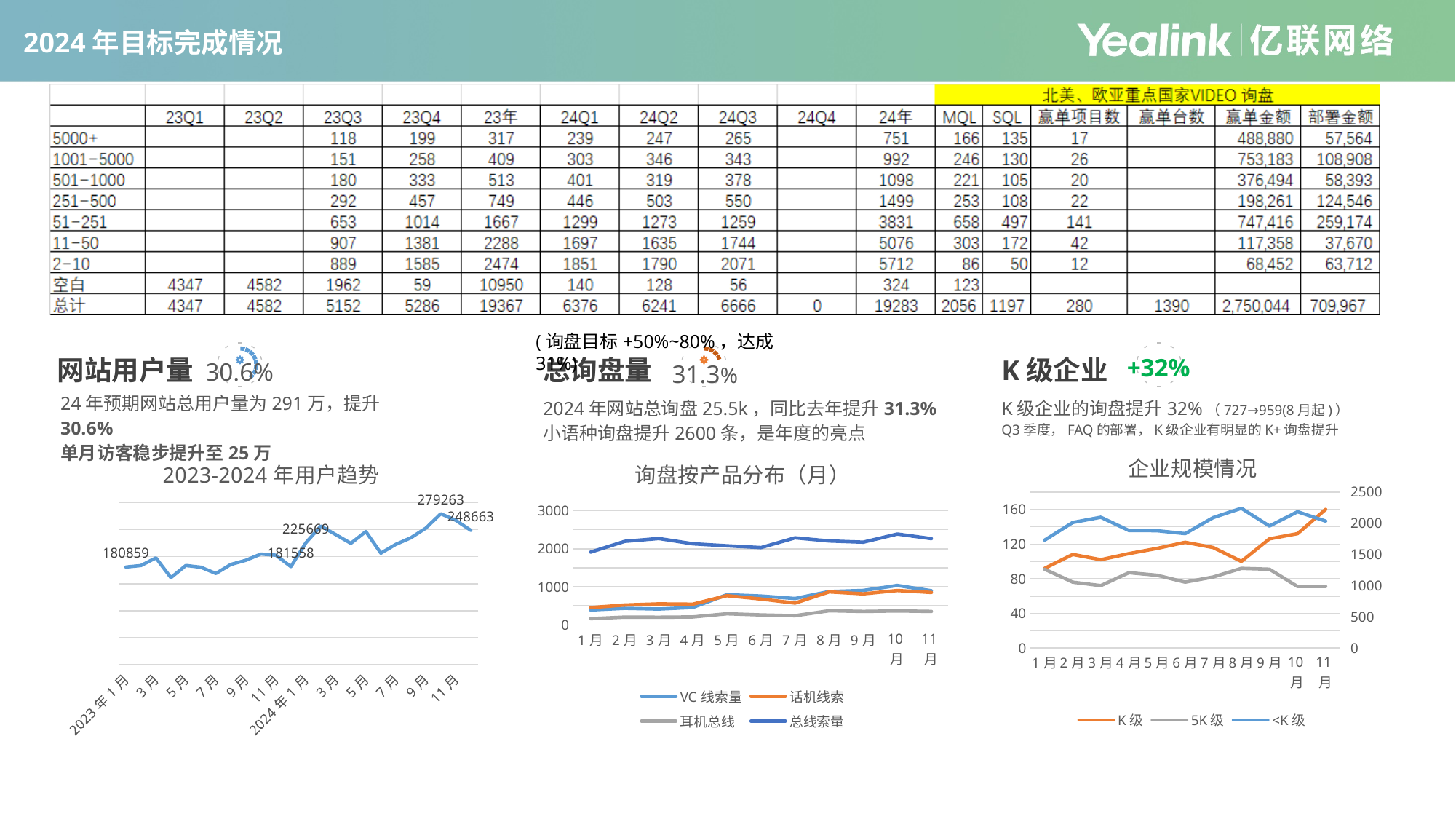
In the "2023-2024 年用户趋势" chart, what is the value labelled at the last point (2024 年 11 月)? 248663 How many months are plotted on the x axis of the "询盘按产品分布（月）" chart? 11 How many series does the legend of the "企业规模情况" chart list? 3 In the "询盘按产品分布（月）" chart, which series is higher in 5 月, 总线索量 or 耳机总线? 总线索量 In the "询盘按产品分布（月）" chart, is the value of 耳机总线 in 1 月 greater or less than 500? less In the "2023-2024 年用户趋势" chart, which labelled value is larger, 225669 or 181558? 225669 What type of chart is the "2023-2024 年用户趋势" chart? line chart How many series does the legend of the "询盘按产品分布（月）" chart list? 4 In the "2023-2024 年用户趋势" chart, what is the highest labelled value? 279263 In the "询盘按产品分布（月）" chart, is the value of 总线索量 in 8 月 greater or less than 2000? greater In the "2023-2024 年用户趋势" chart, what is the value labelled at the first point (2023 年 1 月)? 180859 In the "2023-2024 年用户趋势" chart, what is the difference between the labelled values 279263 and 248663? 30600